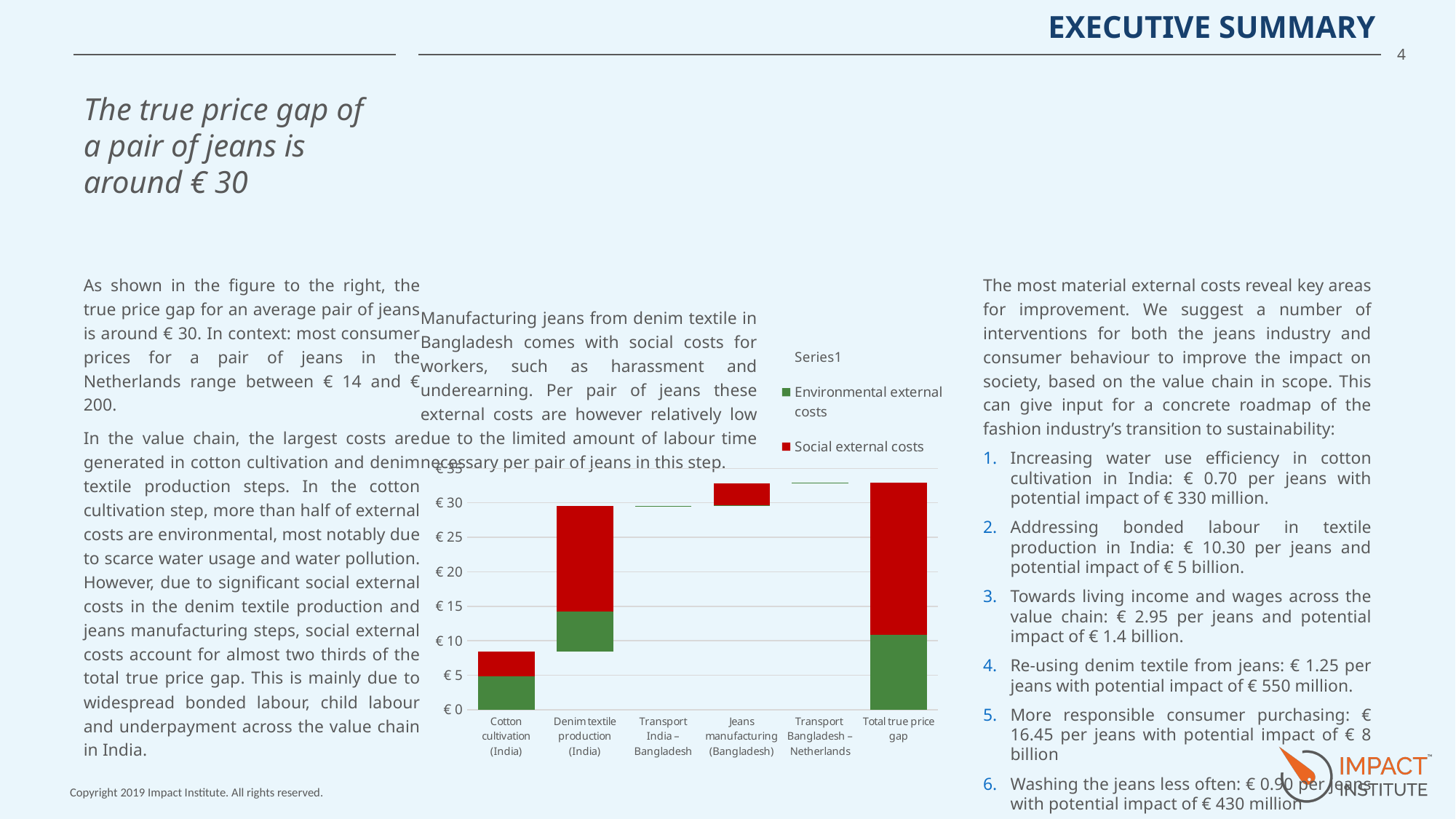
Which has a larger Environmental external costs segment: Cotton cultivation (India) or Total true price gap? Total true price gap Is the total value for Total true price gap greater or less than € 30? greater How many categories are shown along the x axis of the chart? 6 What is the highest value shown on the chart's y axis? € 35 Which category has the largest Environmental external costs segment? Total true price gap Which has a larger Social external costs segment: Cotton cultivation (India) or Denim textile production (India)? Denim textile production (India) How many entries does the chart's legend list? 3 Is the top of the bar for Cotton cultivation (India) greater or less than € 10? less Which category has the largest Social external costs segment? Total true price gap What kind of chart is shown on the slide? Stacked bar chart Is the top of the bar for Jeans manufacturing (Bangladesh) greater or less than € 30? greater What colour represents Social external costs in the chart? Red